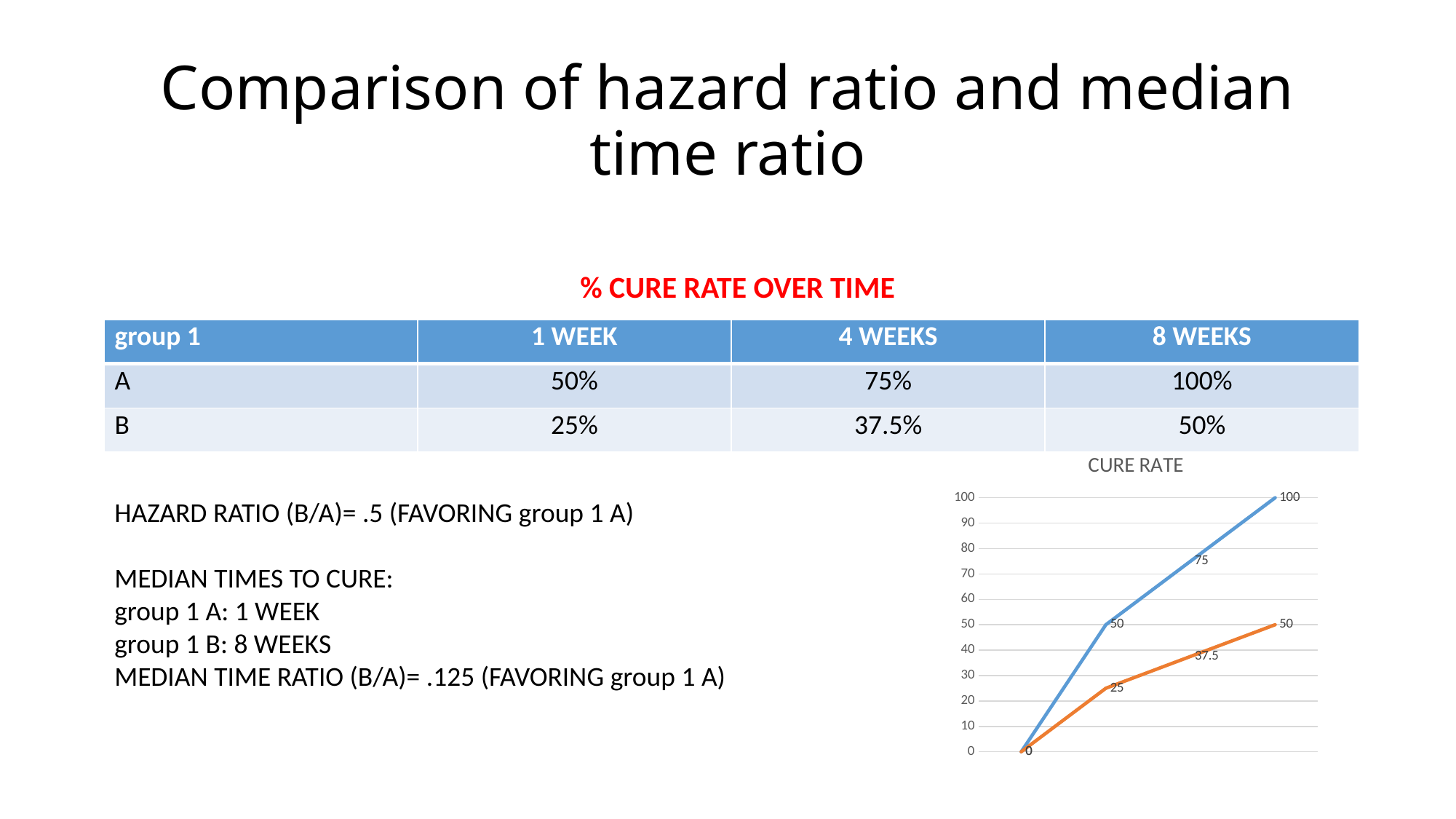
What is the title of the chart on the slide? CURE RATE In the "CURE RATE" chart, what is the difference between the final values of the blue line (100) and the orange line (50)? 50 What is the highest data label on the blue line in the "CURE RATE" chart? 100 What is the maximum value shown on the vertical axis of the "CURE RATE" chart? 100 Do the values on the blue line in the "CURE RATE" chart rise or fall from left to right? rise How many labelled data points does each line have in the "CURE RATE" chart? 4 What kind of chart is the "CURE RATE" chart? line chart What is the highest data label on the orange line in the "CURE RATE" chart? 50 What is the value of the third labelled point on the orange line in the "CURE RATE" chart? 37.5 In the "CURE RATE" chart, which line reaches a higher final value, the blue line or the orange line? blue line In the "CURE RATE" chart, what is the difference between the second labelled points of the blue line (50) and the orange line (25)? 25 What is the value of the third labelled point on the blue line in the "CURE RATE" chart? 75